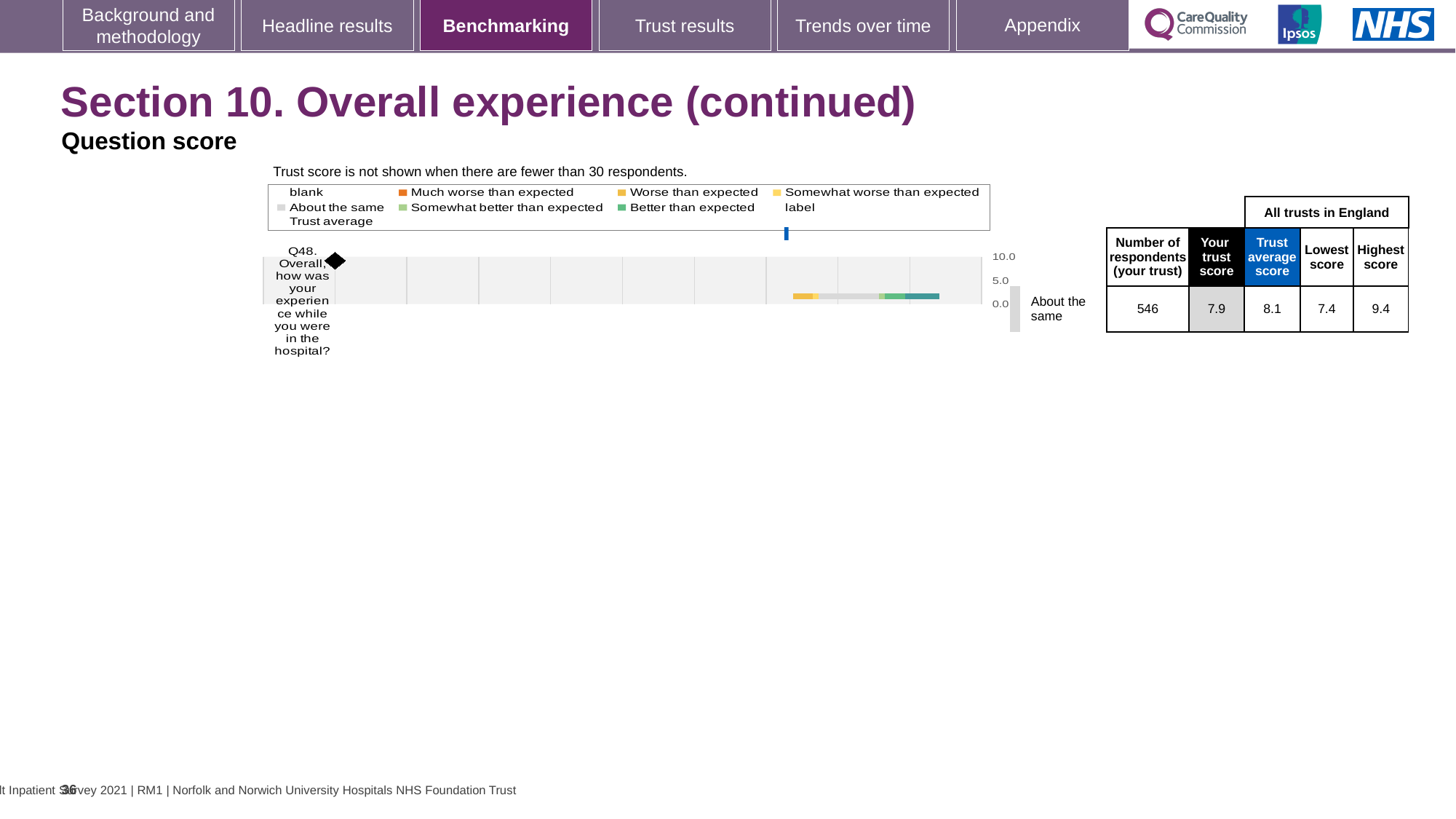
What is the trust score for Q48? 7.9 Which question is plotted on the chart? Q48. Overall, how was your experience while you were in the hospital? What kind of chart is used to show the Q48 question score? bar chart Is the trust score for Q48 greater or less than 5.0? greater Which is larger for Q48, the trust score or the trust average score? Trust average score How many survey questions are plotted on the chart? 1 What benchmarking category is the trust's Q48 score placed in? About the same What is the difference between the highest score and the lowest score for Q48? 2.0 How many respondents from the trust answered Q48? 546 What is the trust average score for Q48 across all trusts in England? 8.1 What is the lowest score for Q48 among all trusts in England? 7.4 What is the highest score for Q48 among all trusts in England? 9.4